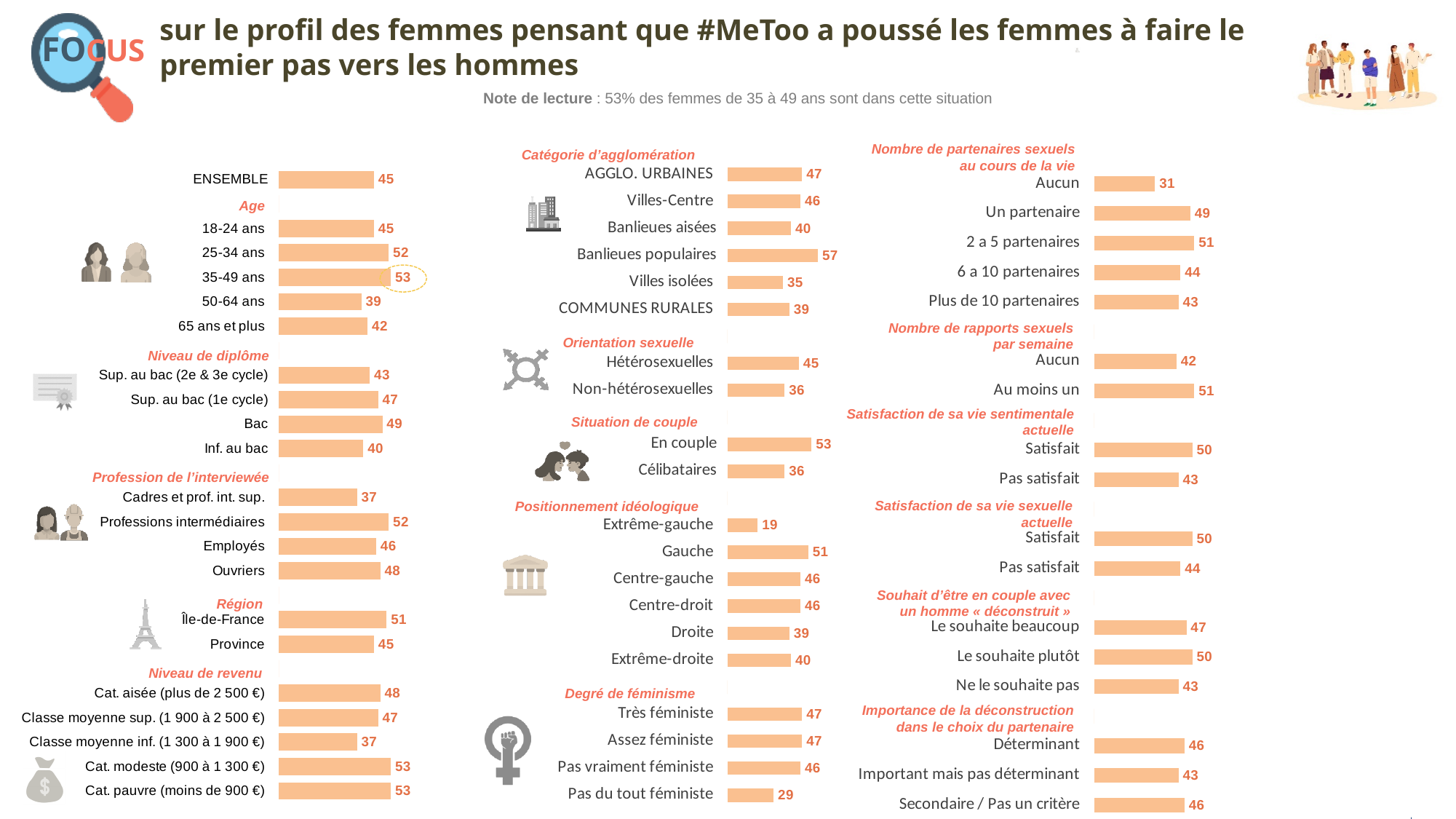
What kind of chart is used on this slide? Bar chart In the Catégorie d'agglomération chart, what is the difference between Banlieues populaires and Villes isolées? 22 In the Positionnement idéologique chart, which category has the lowest value? Extrême-gauche In the Nombre de partenaires sexuels au cours de la vie chart, what is the value for Aucun? 31 In the Nombre de partenaires sexuels au cours de la vie chart, how many categories are shown? 5 In the Degré de féminisme chart, what is the value for Pas du tout féministe? 29 In the Situation de couple chart, which is larger, En couple or Célibataires? En couple In the Catégorie d'agglomération chart, what is the value for Banlieues populaires? 57 In the left-hand chart, what is the value for ENSEMBLE? 45 In the Age section of the left-hand chart, which age group has the highest value? 35-49 ans In the Age section of the left-hand chart, which age group has the lowest value? 50-64 ans In the Niveau de revenu section of the left-hand chart, what is the difference between Cat. pauvre (moins de 900 €) and Classe moyenne inf. (1 300 à 1 900 €)? 16